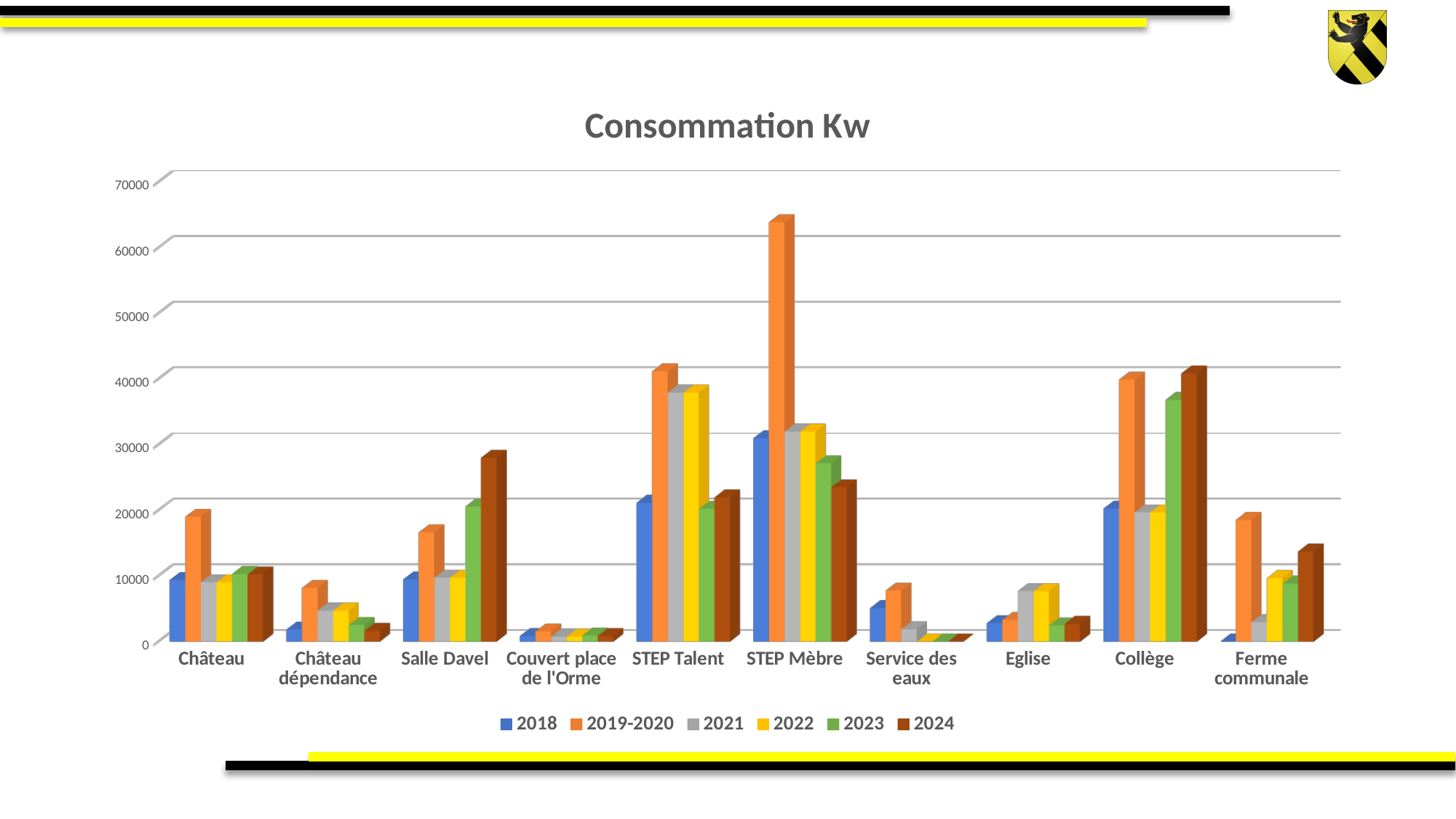
For Ferme communale, which series has the lowest value? 2018 How many series does the legend list? 6 Is the 2024 value for Salle Davel greater or less than 30000? less Is the 2023 value for Collège greater or less than 30000? greater For Salle Davel, which series has the highest value? 2024 For STEP Mèbre, which series has the highest value? 2019-2020 Which category contains the tallest bar in the chart? STEP Mèbre For STEP Talent, which is larger: the 2019-2020 value or the 2018 value? 2019-2020 Is the 2019-2020 value for STEP Mèbre greater or less than 60000? greater What kind of chart is shown on the slide? bar chart How many categories are shown on the x axis of the chart? 10 What is the title of the chart? Consommation Kw